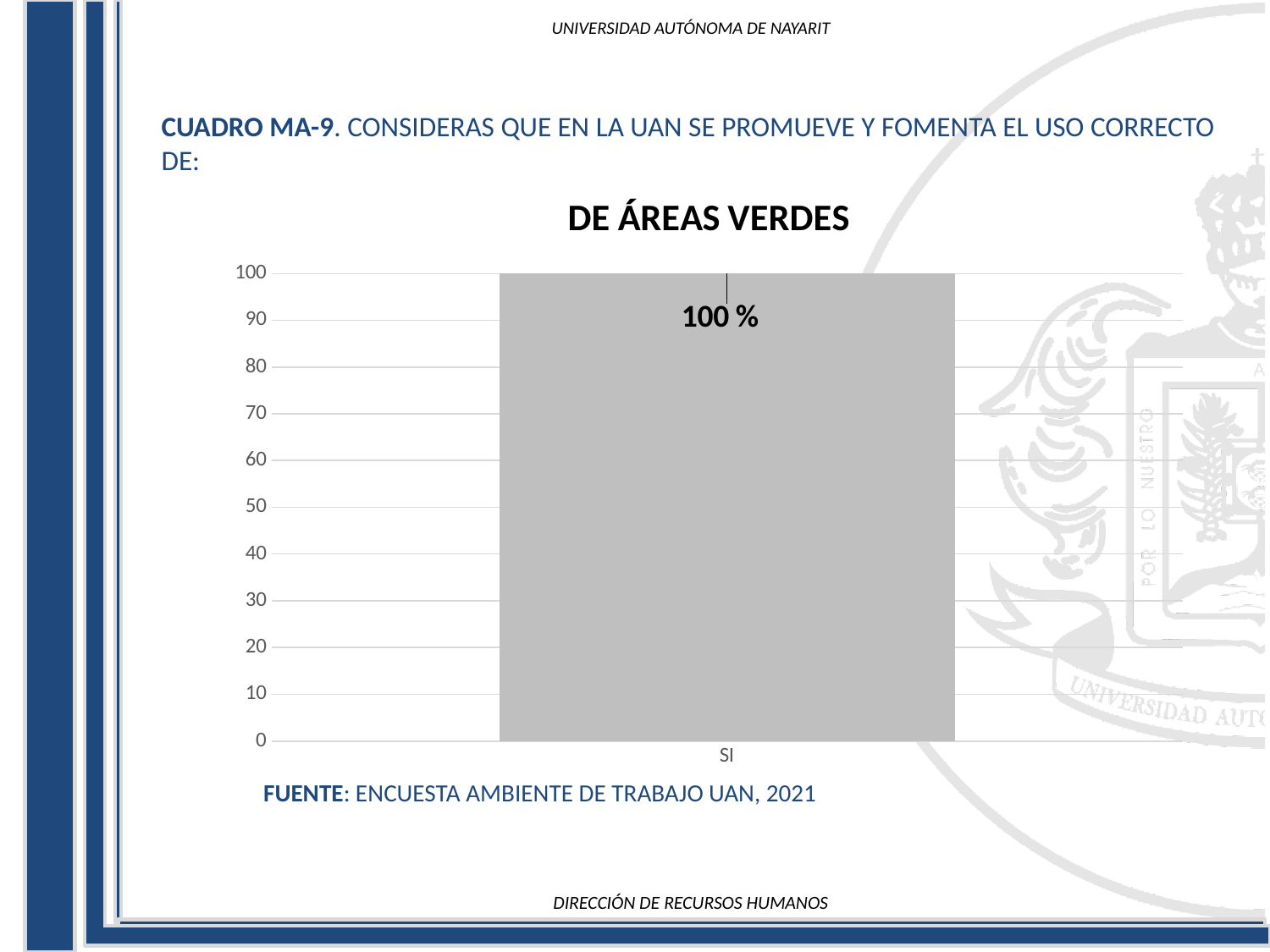
What kind of chart is shown on the slide? bar chart Is the value for SI greater or less than 50? greater What is the value shown for the SI category? 100 % Which category has the highest value? SI How many categories are plotted on the x axis? 1 What is the highest value shown on the vertical axis? 100 What is the label of the only category on the x axis? SI What is the title of the chart? DE ÁREAS VERDES